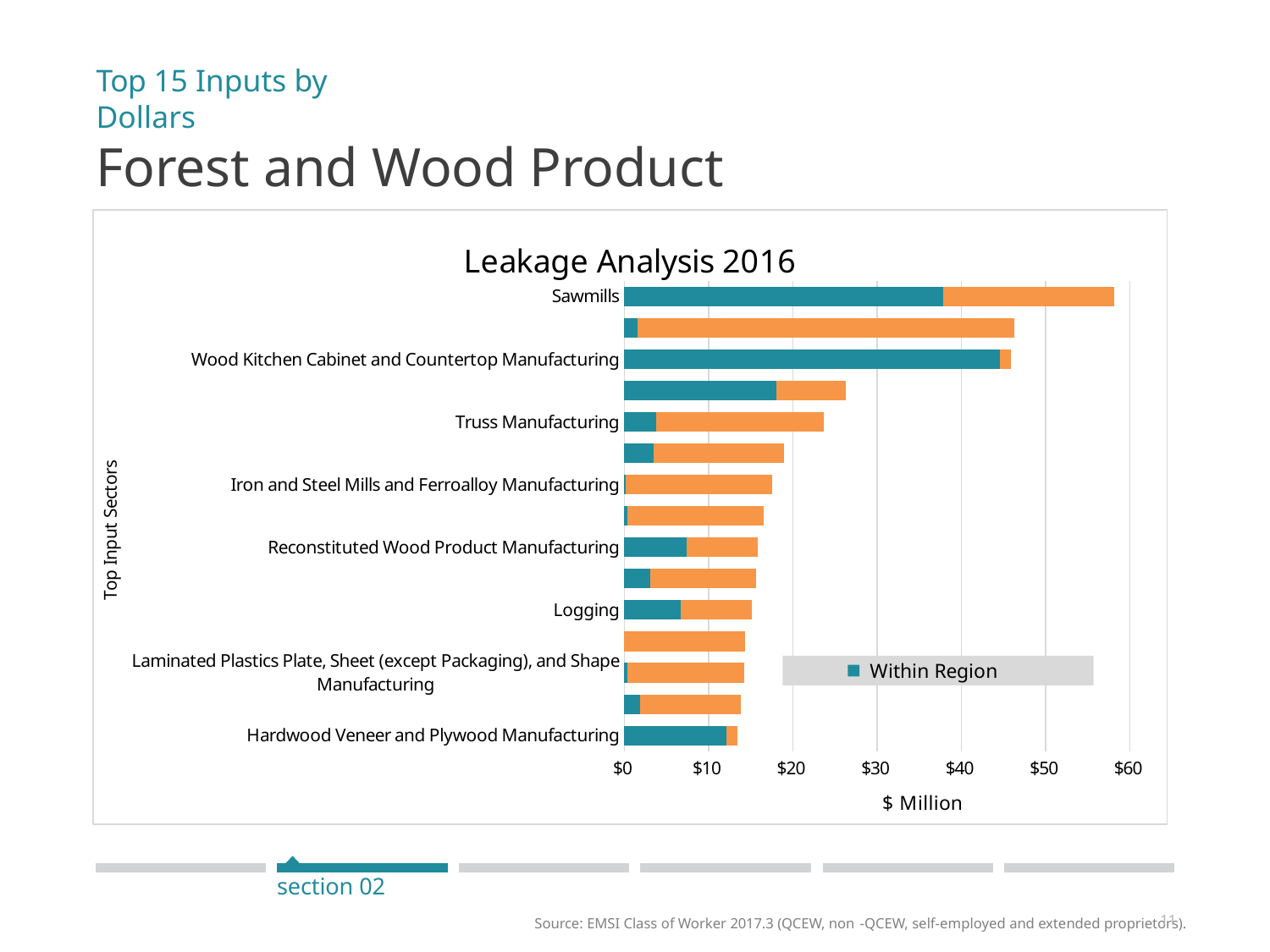
Which labeled input sector has the shortest total bar? Hardwood Veneer and Plywood Manufacturing Which input sector has the longest total bar? Sawmills Which has the larger Within Region value, Sawmills or Wood Kitchen Cabinet and Countertop Manufacturing? Wood Kitchen Cabinet and Countertop Manufacturing What is the title of the chart? Leakage Analysis 2016 Is the total value for Sawmills greater or less than $50 million? greater What is the label on the horizontal axis of the chart? $ Million Is the total value for Iron and Steel Mills and Ferroalloy Manufacturing greater or less than $20 million? less What kind of chart is shown on the slide? Stacked horizontal bar chart Is the total value for Truss Manufacturing greater or less than $20 million? greater Do the total bar lengths increase or decrease going from the top of the chart to the bottom? decrease How many bars are plotted in the chart? 15